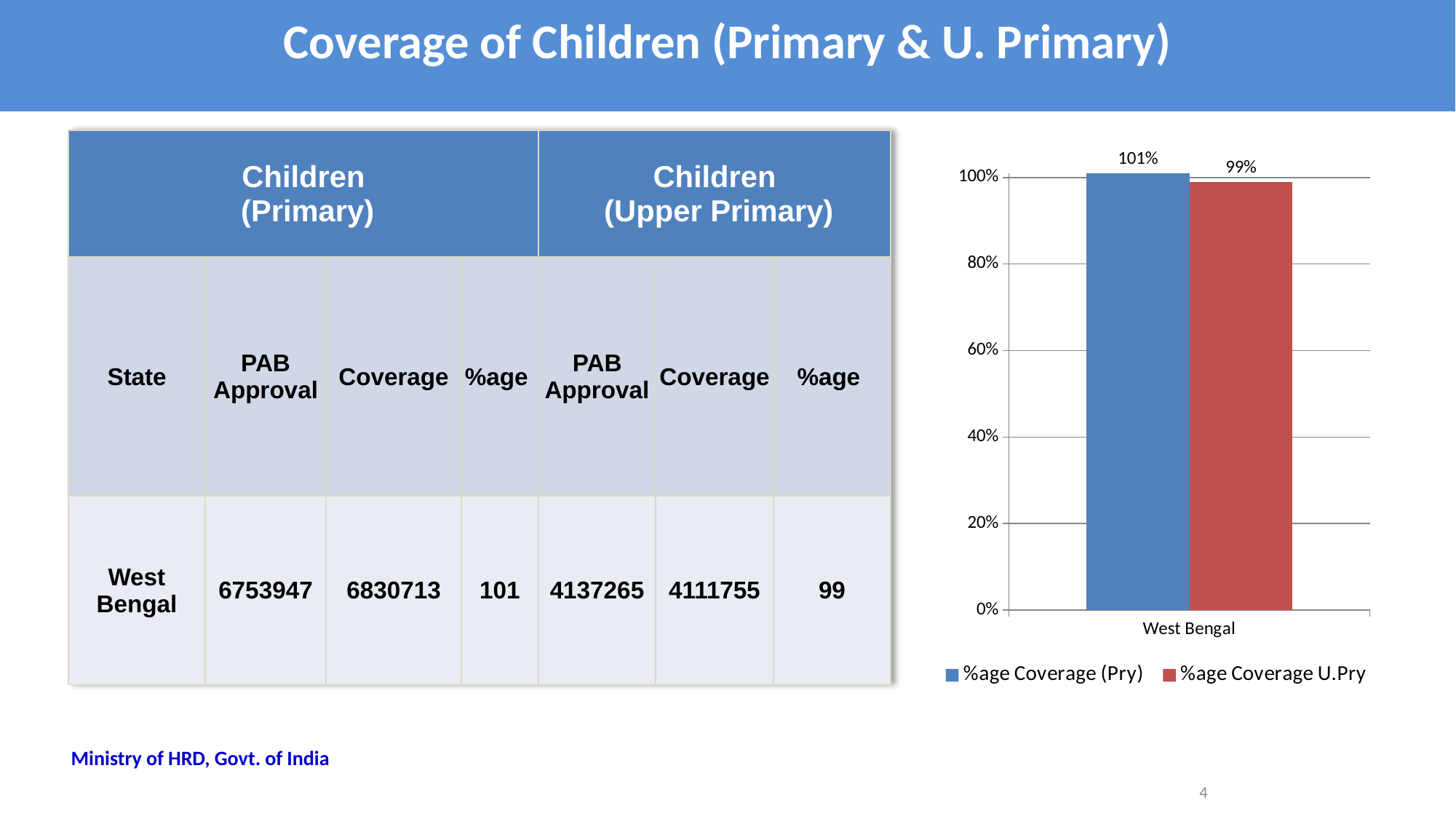
Which series has the lower value for West Bengal in the chart? %age Coverage U.Pry How many categories are shown on the x axis of the chart? 1 What is the category label on the x axis of the chart? West Bengal What is the difference between %age Coverage (Pry) and %age Coverage U.Pry for West Bengal in the chart? 2% What is the value of %age Coverage U.Pry for West Bengal in the chart? 99% What is the value of %age Coverage (Pry) for West Bengal in the chart? 101% What kind of chart is shown on the slide? bar chart What colour is the bar for %age Coverage U.Pry in the chart? red Which series has the higher value for West Bengal in the chart? %age Coverage (Pry) Is %age Coverage (Pry) or %age Coverage U.Pry larger for West Bengal in the chart? %age Coverage (Pry) Is the value for %age Coverage U.Pry greater or less than 80%? greater How many series does the chart legend list? 2